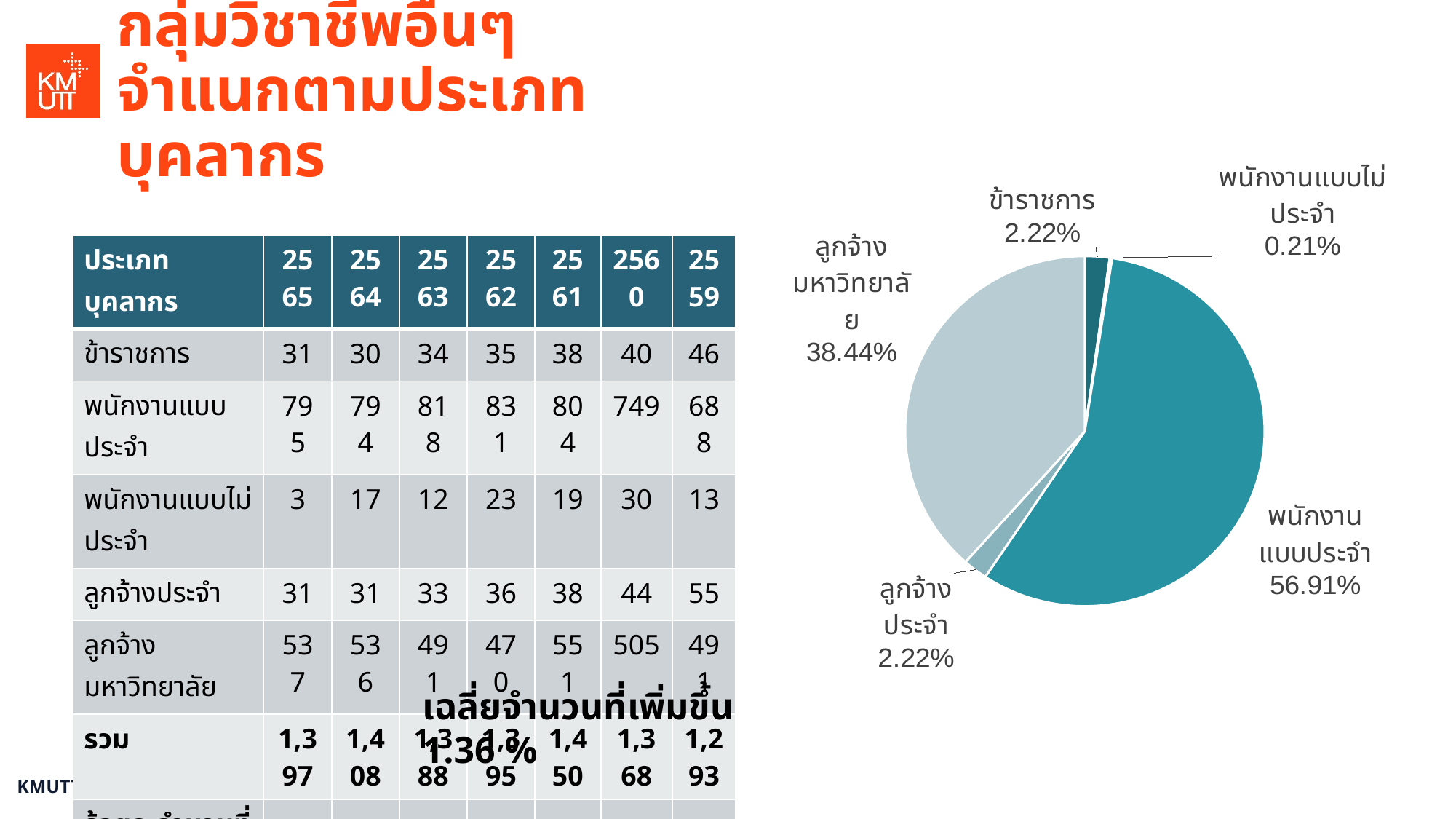
Which category has the smallest slice in the pie chart? พนักงานแบบไม่ประจำ What kind of chart is shown on the right side of the slide? pie chart What share of the pie chart is ข้าราชการ? 2.22% In the pie chart, which is larger: ลูกจ้างมหาวิทยาลัย or ข้าราชการ? ลูกจ้างมหาวิทยาลัย In the pie chart, what is the difference in percentage points between พนักงานแบบประจำ and ลูกจ้างมหาวิทยาลัย? 18.47% What share of the pie chart is ลูกจ้างมหาวิทยาลัย? 38.44% Which category has the largest slice in the pie chart? พนักงานแบบประจำ How many slices does the pie chart have? 5 What share of the pie chart is ลูกจ้างประจำ? 2.22% What share of the pie chart is พนักงานแบบไม่ประจำ? 0.21% In the pie chart, is the share for พนักงานแบบประจำ greater or less than 50%? greater What share of the pie chart is พนักงานแบบประจำ? 56.91%